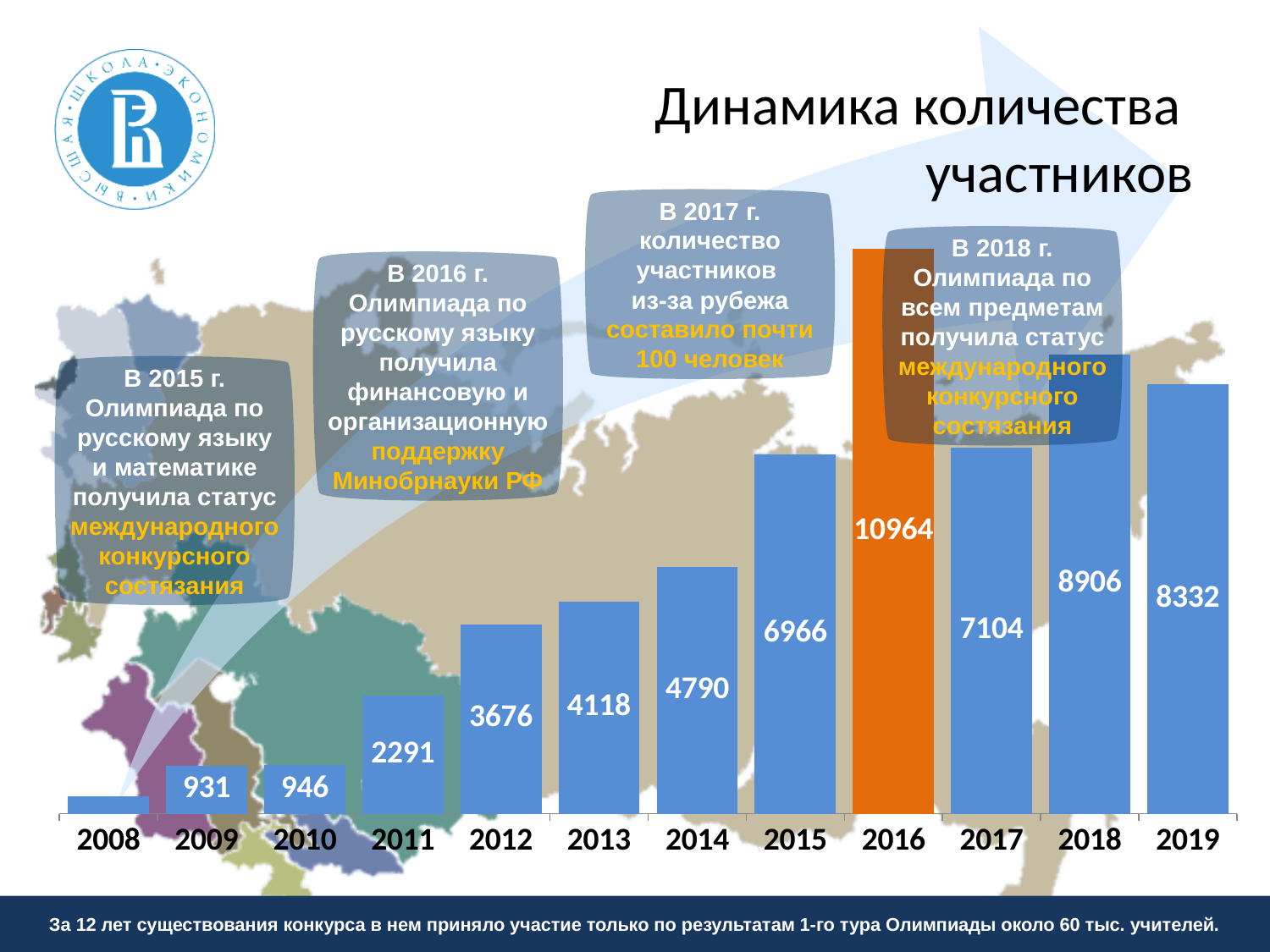
What type of chart is shown on the slide? bar chart Which is larger, the value for 2017 or the value for 2015? 2017 Which bar is coloured orange instead of blue? 2016 Which year has the lowest value? 2008 What is the value for 2019? 8332 What is the title of the chart? Динамика количества участников What is the value for 2016? 10964 How many years (categories) are shown on the x axis of the chart? 12 Which year has the highest value? 2016 What is the difference between the values for 2018 and 2019? 574 What is the difference between the values for 2016 and 2015? 3998 What is the value for 2012? 3676